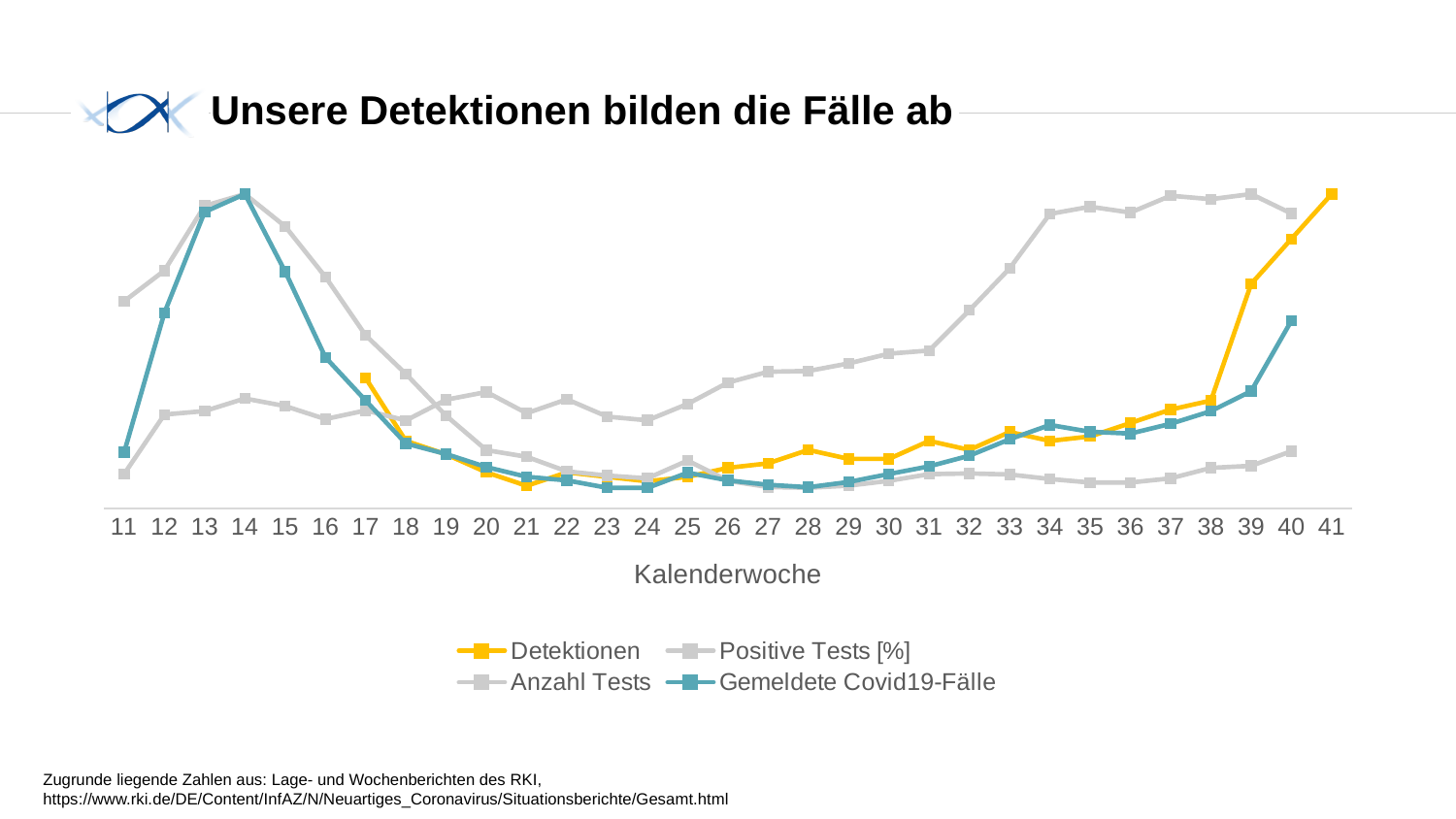
Does the Detektionen series rise or fall from week 33 to week 41? rise In which calendar week does the Gemeldete Covid19-Fälle series reach its highest value? 14 How many series does the legend list? 4 What kind of chart is shown on the slide? line chart Does the Gemeldete Covid19-Fälle series rise or fall from week 14 to week 24? fall In which calendar week does the Detektionen series begin? 17 What is the title of the slide above the chart? Unsere Detektionen bilden die Fälle ab In which calendar week does the Detektionen series reach its highest value? 41 Does the Gemeldete Covid19-Fälle series rise or fall from week 11 to week 14? rise How many calendar weeks are shown on the x axis? 31 In week 39, which is higher: Detektionen or Gemeldete Covid19-Fälle? Detektionen What is the title of the x axis? Kalenderwoche